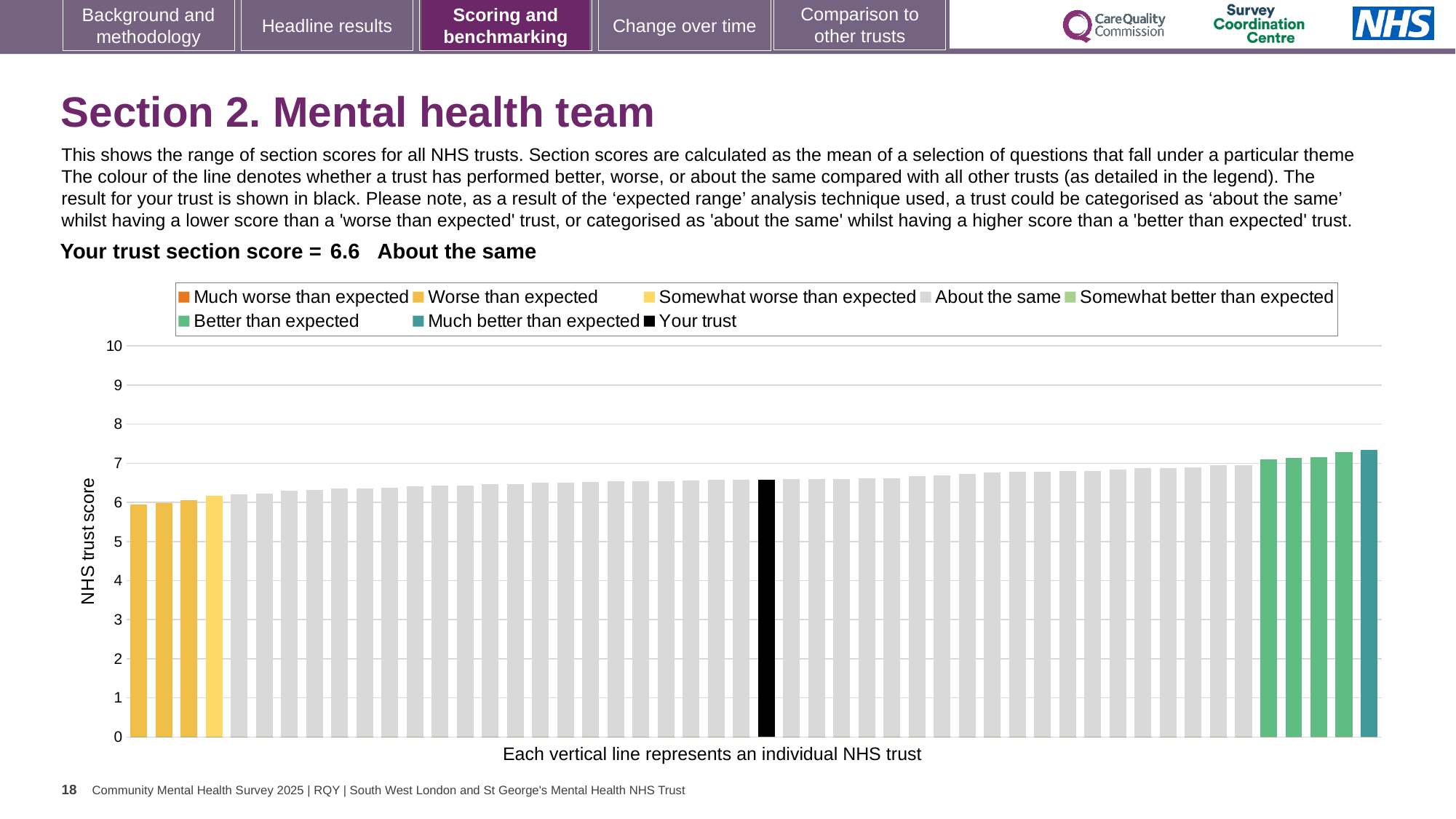
Is the value of the lowest bar in the chart greater or less than 7? less How many entries does the chart legend list? 8 What kind of chart is shown on the slide? bar chart Do the bar values rise or fall from left to right across the chart? rise Is the value of the tallest bar in the chart greater or less than 7? greater What is the section score for your trust shown on the slide? 6.6 Is the value of the highest bar in the chart greater or less than 8? less How many bars in the chart are coloured as 'Much better than expected'? 1 Which benchmarking category is your trust placed in for this section? About the same What is the label on the vertical axis of the chart? NHS trust score What does each vertical line in the chart represent, according to the caption below the chart? an individual NHS trust Which legend category does the tallest bar in the chart belong to? Much better than expected